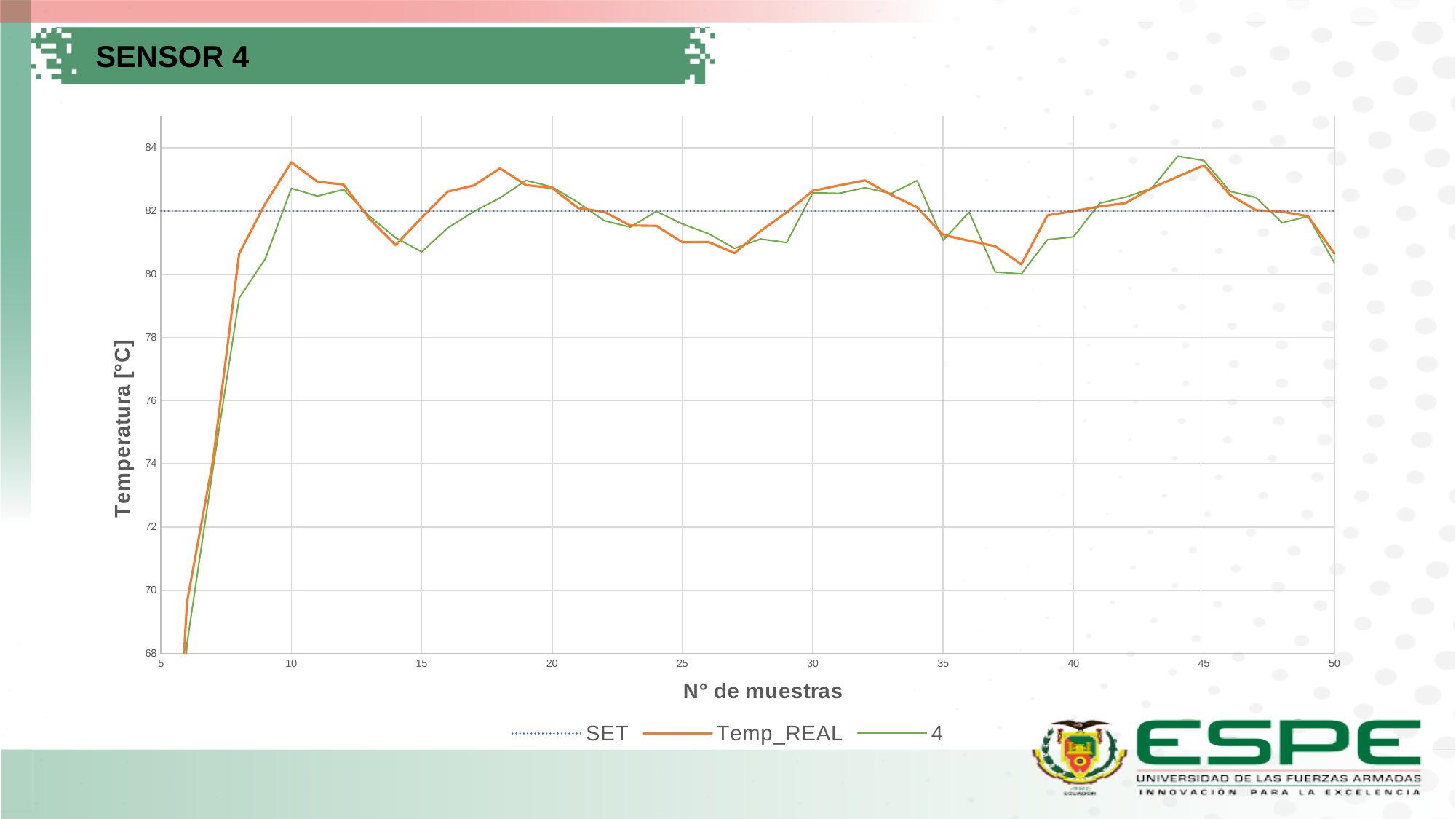
What kind of chart is shown on the slide? line chart Is the Temp_REAL value at sample 10 greater or less than 82? greater What is the title of the slide containing the chart? SENSOR 4 Do the Temp_REAL values rise or fall between sample 5 and sample 10? rise How many series does the legend list? 3 At sample 8, which series has the larger value, Temp_REAL or 4? Temp_REAL Is the value of series 4 at sample 8 greater or less than 80? less What is the value of the SET series across the samples? 82 What is the highest value shown on the x axis? 50 Is the Temp_REAL value at sample 7 greater or less than 72? greater What is the label of the x axis? N° de muestras